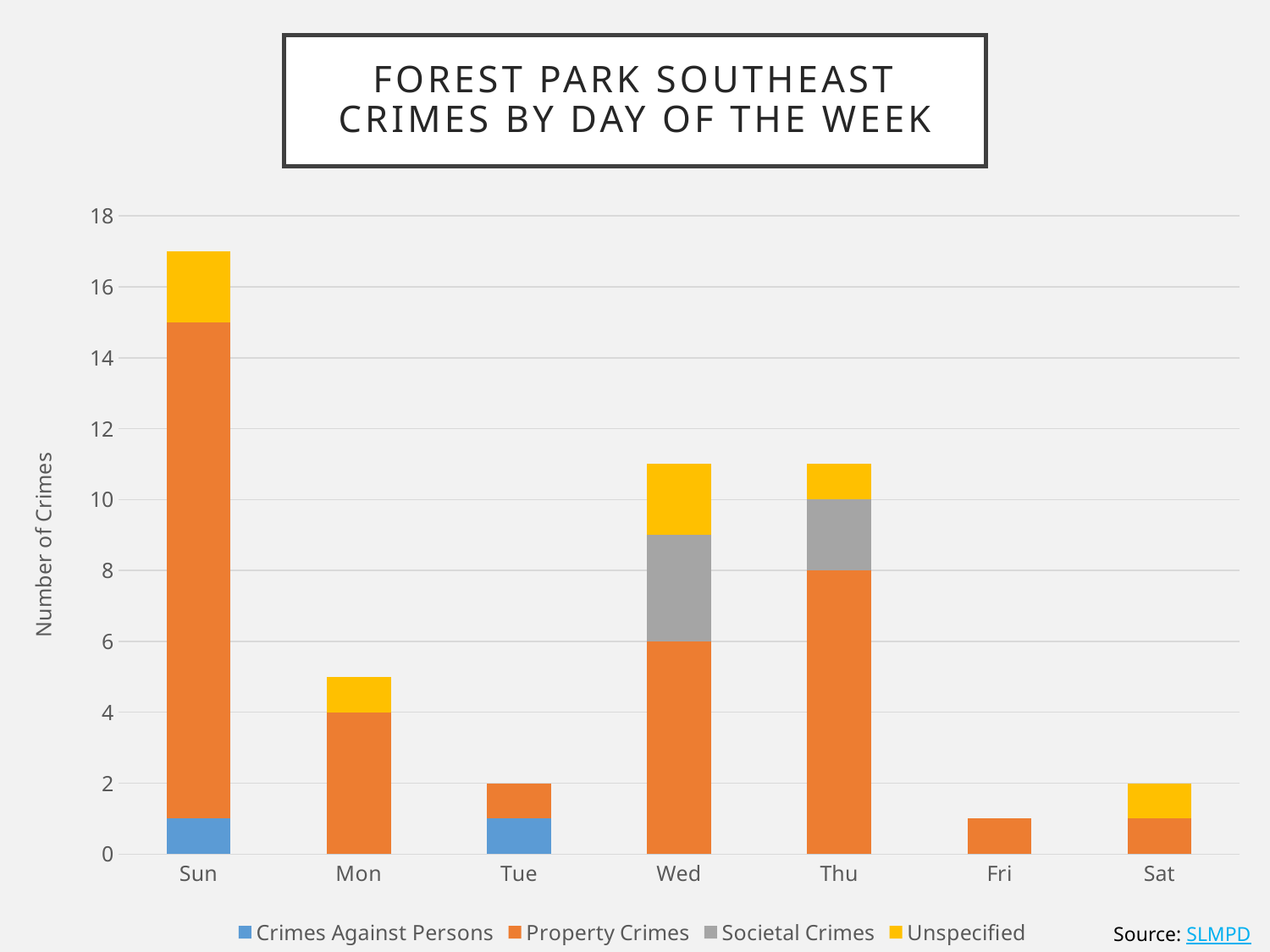
Which day has more total crimes, Sun or Wed? Sun What is the number of Property Crimes on Wed? 6 Is the total number of crimes on Sun greater or less than 16? greater What is the number of Property Crimes on Thu? 8 Which day has the highest total number of crimes? Sun Which day has the lowest total number of crimes? Fri What is the label of the y axis? Number of Crimes Is the total number of crimes on Fri greater or less than 2? less What kind of chart is shown on the slide? bar chart Is the total number of crimes on Wed greater or less than 10? greater How many days of the week are shown on the x axis? 7 How many series does the legend list? 4